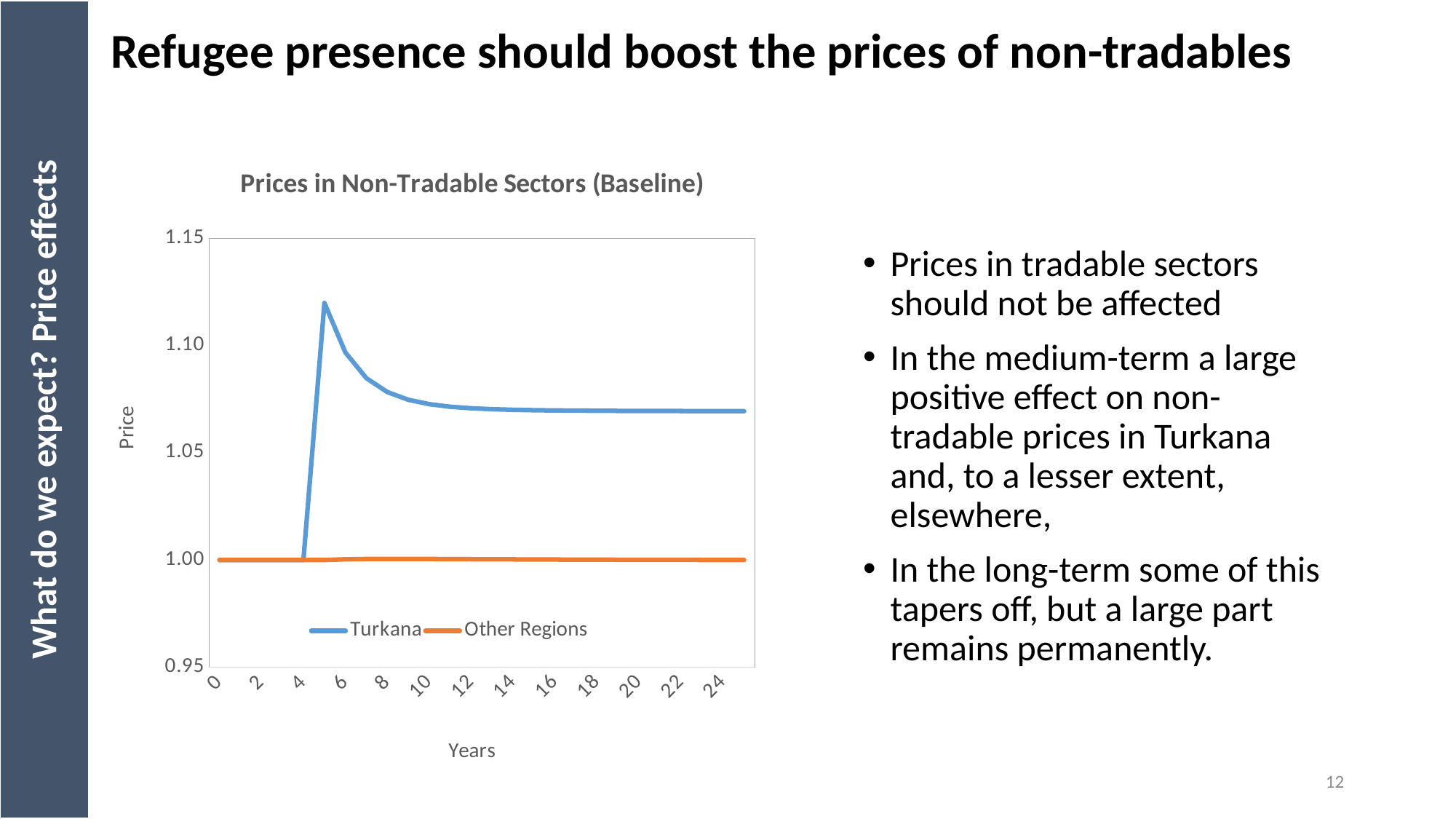
Which series reaches the highest value on the chart? Turkana At year 10, which series has the higher value, Turkana or Other Regions? Turkana Does the Turkana series rise or fall between year 4 and year 5? rise What kind of chart is shown on the slide? line chart Is the value for Other Regions at year 12 greater or less than 1.05? less How many series does the legend list? 2 Does the Turkana series rise or fall between year 6 and year 24? fall What are the two series named in the legend? Turkana and Other Regions Is the value for Turkana at year 20 greater or less than 1.10? less What is the title of the chart? Prices in Non-Tradable Sectors (Baseline) Is the peak value of the Turkana series greater or less than 1.10? greater